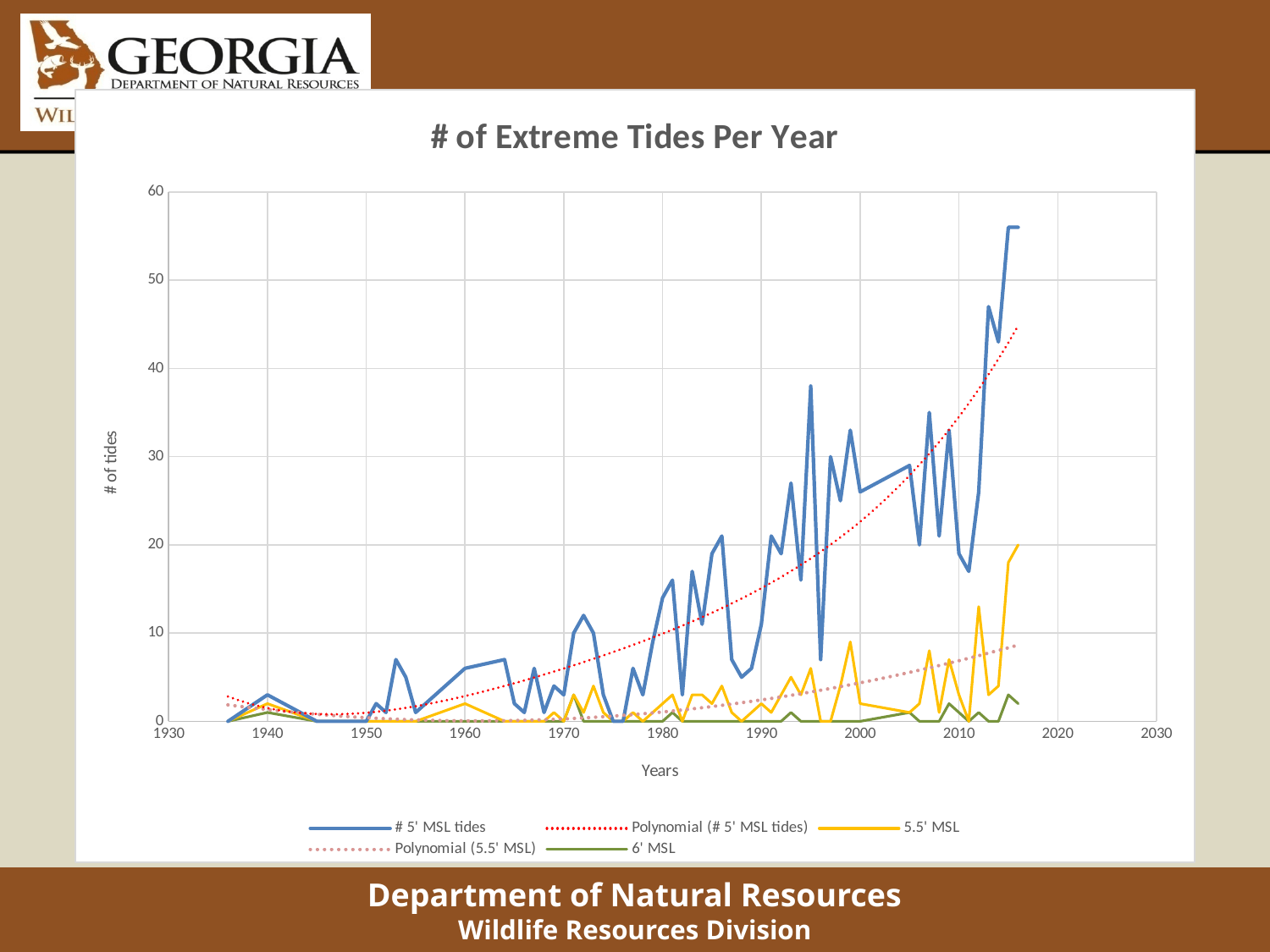
How many series does the legend list? 5 Is the highest value of the 5.5' MSL series greater or less than 10? greater Does the Polynomial (# 5' MSL tides) trend line rise or fall along the x axis? rise Is the highest value of the # 5' MSL tides series greater or less than 50? greater Which series has the lowest values overall: 5.5' MSL or 6' MSL? 6' MSL Overall, does the # 5' MSL tides series rise or fall from 1930 to 2020? rise What is the title of the chart? # of Extreme Tides Per Year Is the highest value of the 6' MSL series greater or less than 10? less Which series reaches the highest value on the chart: # 5' MSL tides or 5.5' MSL? # 5' MSL tides What is the label on the vertical axis of the chart? # of tides What kind of chart is shown on the slide? line chart In which decade does the # 5' MSL tides series reach its highest value? 2010s